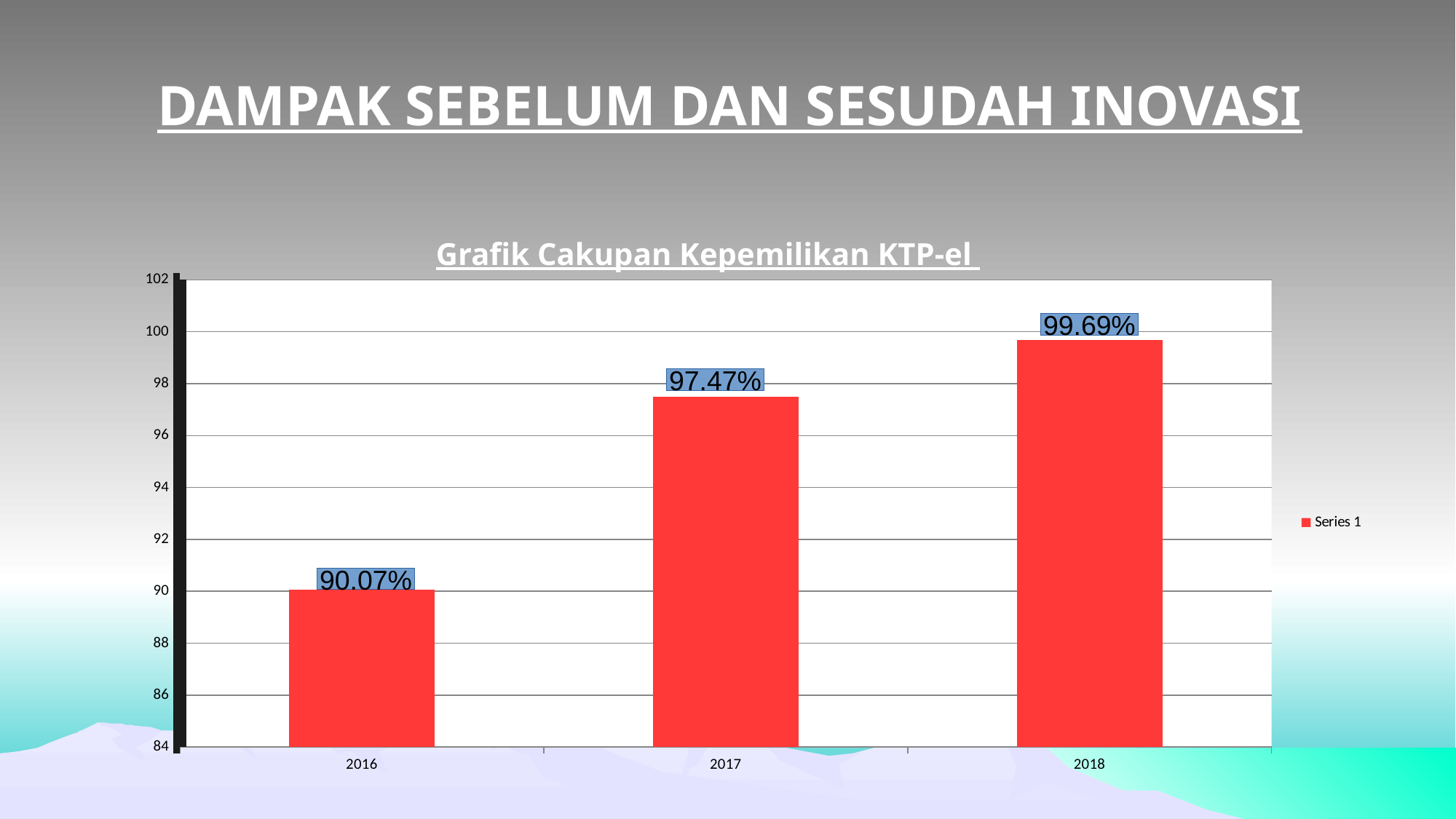
Which year has the lowest value? 2016 What is the difference between the values for 2018 and 2016? 9.62% How many years are shown on the x axis? 3 What kind of chart is shown? bar chart What is the difference between the values for 2017 and 2016? 7.40% Which is larger, the value for 2017 or the value for 2018? 2018 What is the value for 2017? 97.47% Which year has the highest value? 2018 What is the value for 2016? 90.07% What is the value for 2018? 99.69% Is the value for 2016 greater or less than 92? less How many series does the legend list? 1